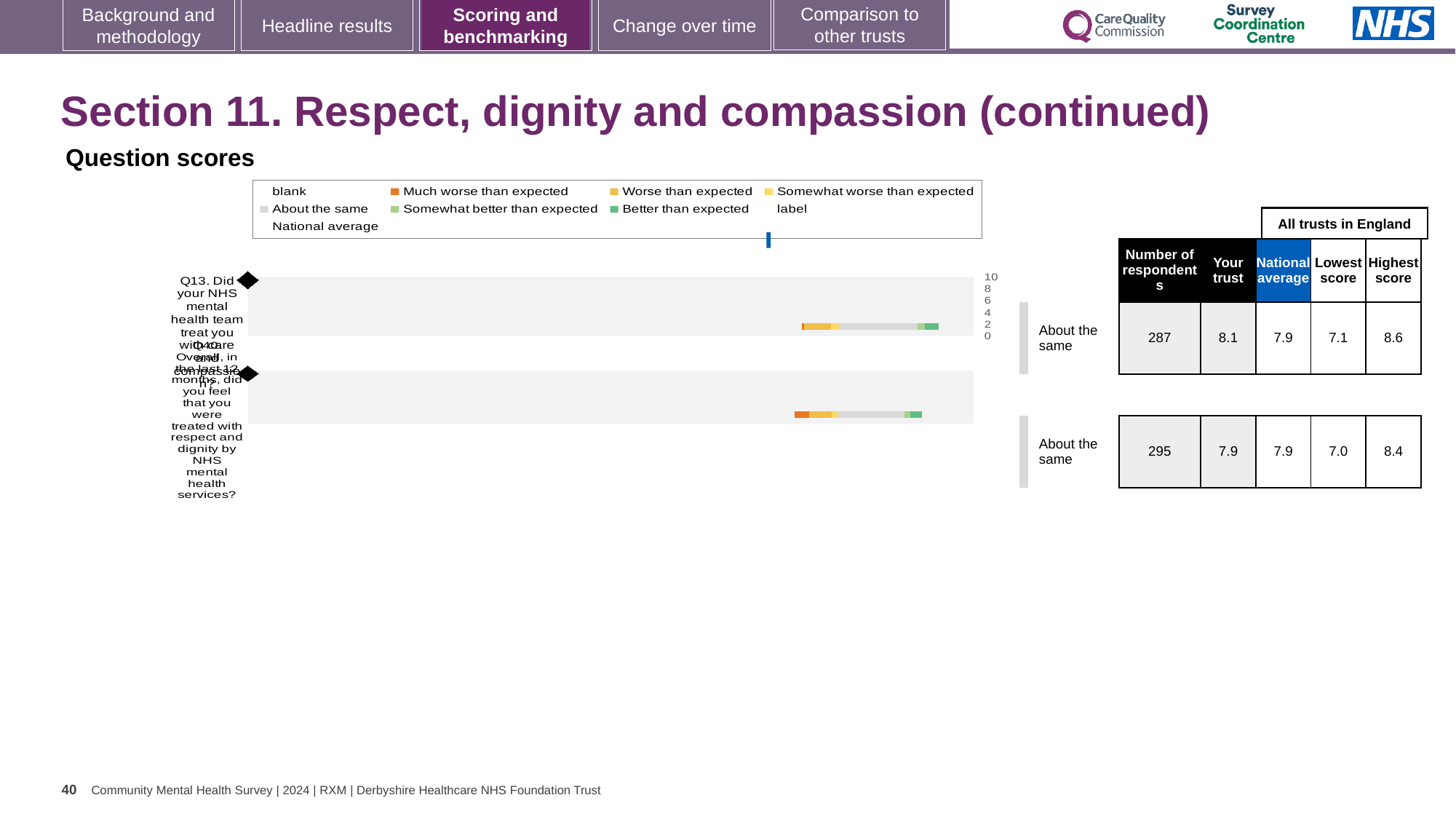
How many questions (categories) are plotted in the Question scores chart? 2 What is the lowest score among all trusts in England for Q14? 7.0 What benchmark category is shown for Q13 next to the chart? About the same What is the "Your trust" score for Q14 in the table beside the chart? 7.9 Which question has the higher "Your trust" score, Q13 or Q14? Q13 What is the highest score among all trusts in England for Q13? 8.6 How many respondents answered Q14? 295 What is the national average score for Q13? 7.9 How many respondents answered Q13? 287 What is the difference between the highest and lowest scores for Q14 across all trusts in England? 1.4 What is the "Your trust" score for Q13 in the table beside the chart? 8.1 What kind of chart is shown under "Question scores"? bar chart